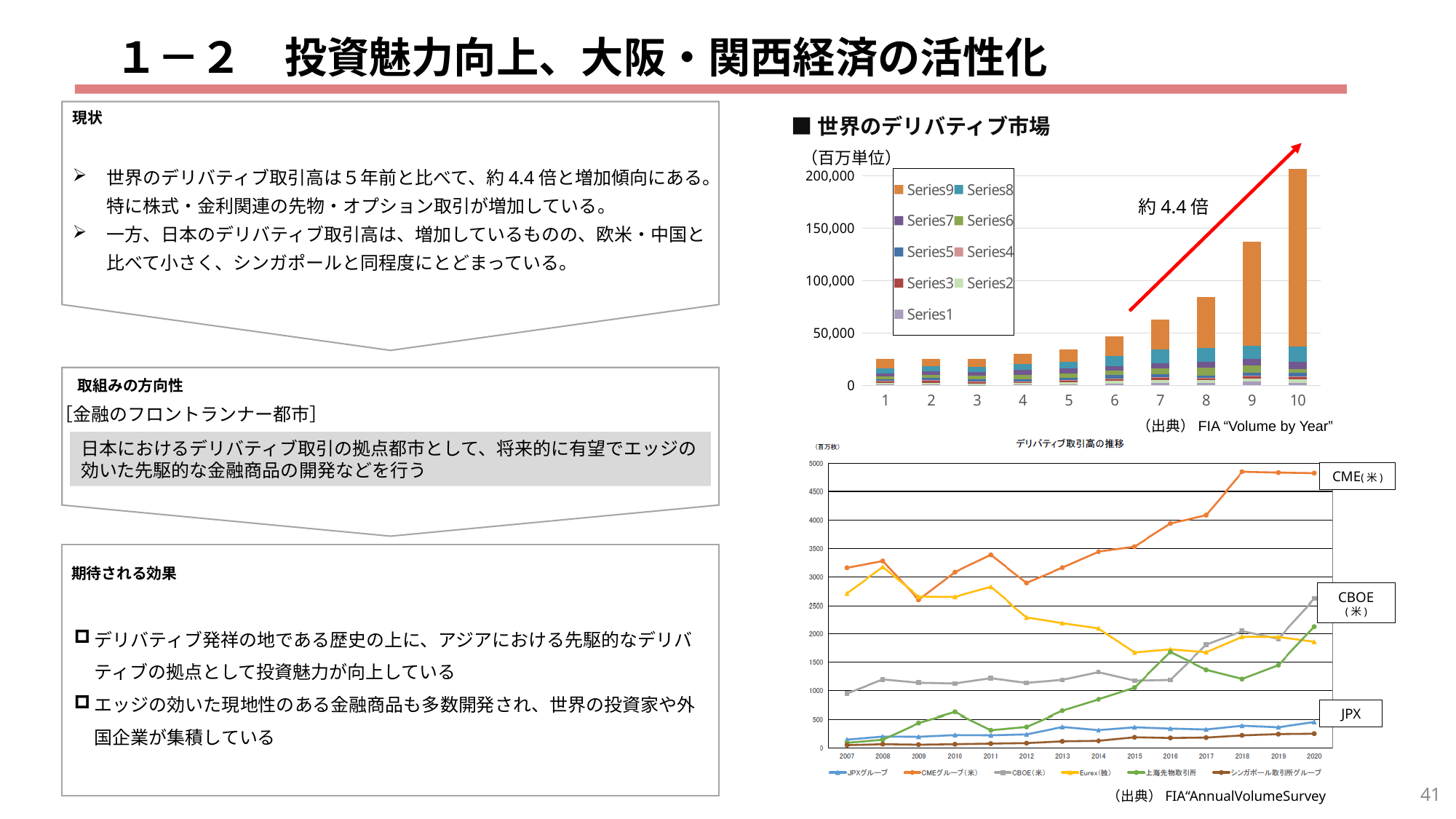
What kind of chart is the top-right chart titled 世界のデリバティブ市場? bar chart What kind of chart is the bottom-right chart titled デリバティブ取引高の推移? line chart In the bottom-right line chart (デリバティブ取引高の推移), is the value for CMEグループ(米) in 2018 greater or less than 4500? greater In the bottom-right line chart (デリバティブ取引高の推移), how many series does the legend list? 6 In the top-right bar chart (世界のデリバティブ市場), how many categories are shown on the x axis? 10 In the bottom-right line chart (デリバティブ取引高の推移), which is larger in 2020: CBOE(米) or Eurex(独)? CBOE(米) In the top-right bar chart (世界のデリバティブ市場), is the total for category 9 greater or less than 100,000? greater In the top-right bar chart (世界のデリバティブ市場), do the stacked bar totals rise or fall from category 1 to category 10? rise In the top-right bar chart (世界のデリバティブ市場), how many series does the legend list? 9 In the bottom-right line chart (デリバティブ取引高の推移), which series has the highest value in 2020? CMEグループ(米) In the top-right bar chart (世界のデリバティブ市場), which category has the tallest stacked bar? 10 In the top-right bar chart (世界のデリバティブ市場), is the total for category 8 greater or less than 100,000? less